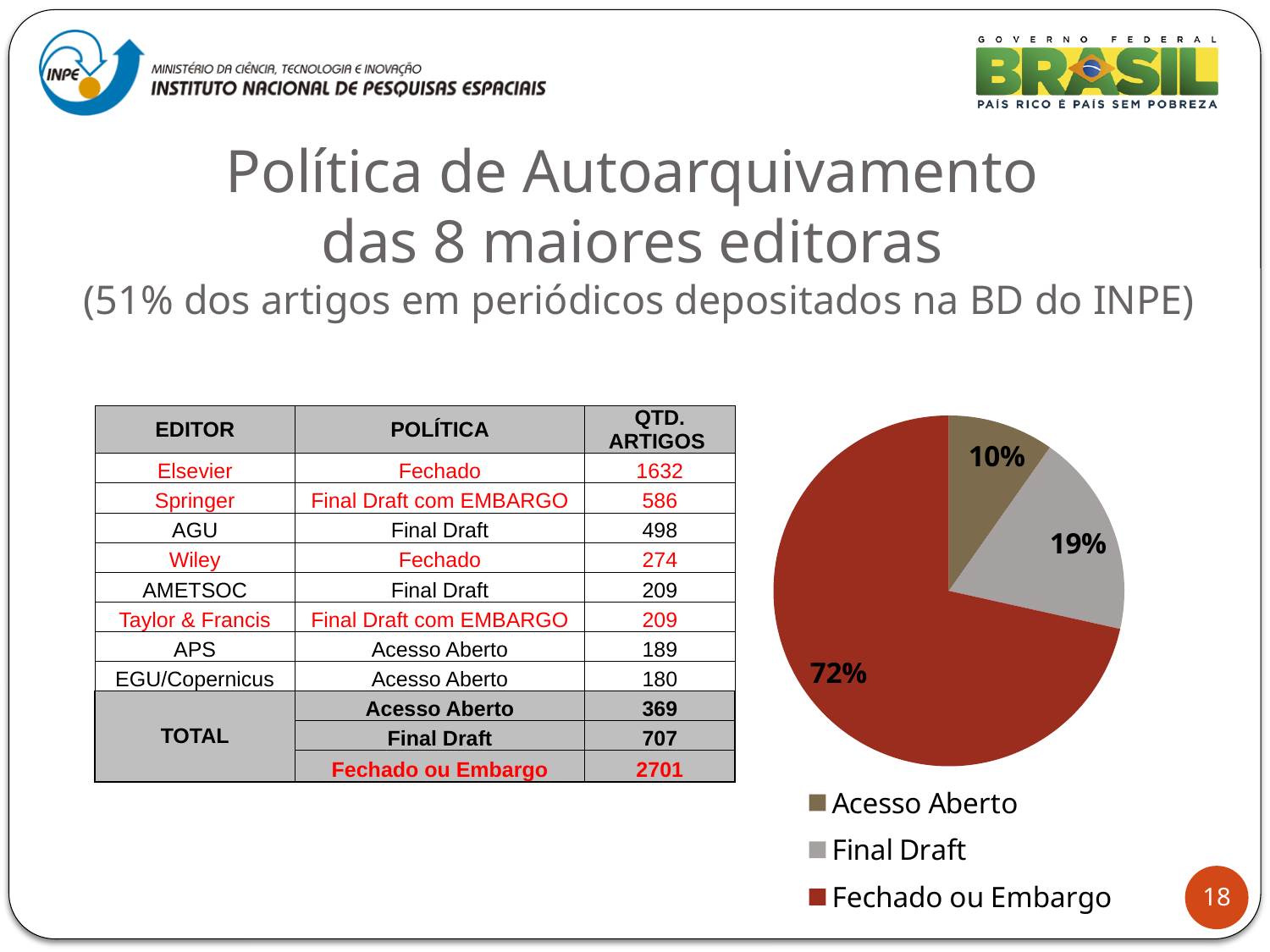
Which slice is larger, Final Draft or Acesso Aberto? Final Draft Which category has the smallest slice of the pie? Acesso Aberto What is the difference in percentage points between the Final Draft slice and the Acesso Aberto slice? 9 What share of the pie does Fechado ou Embargo represent? 72% How many entries does the legend of the pie chart list? 3 Which category has the largest slice of the pie? Fechado ou Embargo What is the difference in percentage points between the Fechado ou Embargo slice and the Final Draft slice? 53 What share of the pie does Acesso Aberto represent? 10% What kind of chart is shown on the slide? pie chart What colour is the Fechado ou Embargo slice in the pie chart? red How many slices does the pie chart have? 3 What share of the pie does Final Draft represent? 19%